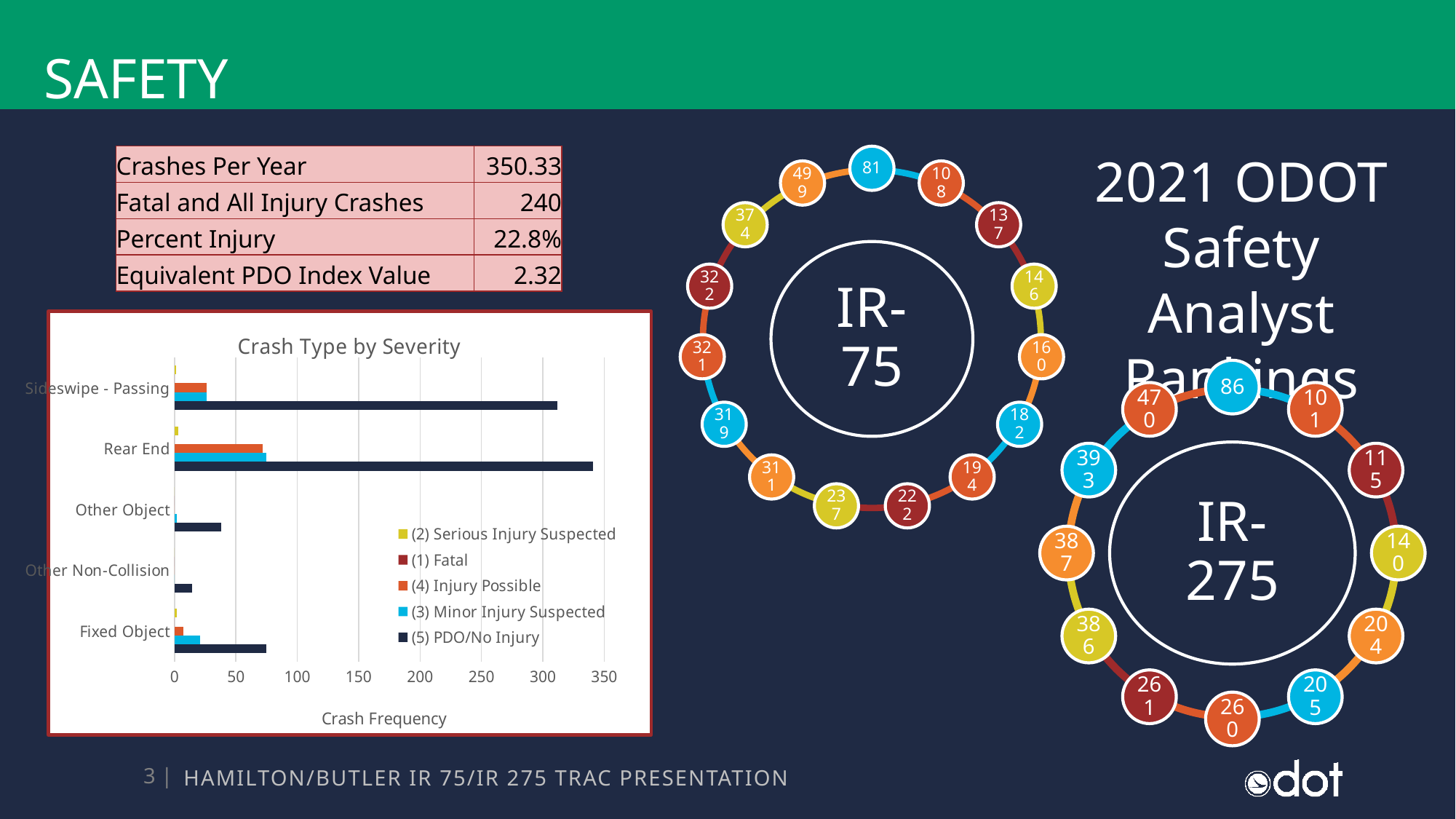
In the "Crash Type by Severity" chart, which crash type has the larger (5) PDO/No Injury value: Fixed Object or Other Object? Fixed Object What is the x-axis label of the "Crash Type by Severity" chart? Crash Frequency In the "Crash Type by Severity" chart, is the (5) PDO/No Injury value for Other Object greater or less than 50? less In the "Crash Type by Severity" chart, which crash type has the lowest (5) PDO/No Injury value? Other Non-Collision How many series does the legend of the "Crash Type by Severity" chart list? 5 In the "Crash Type by Severity" chart, is the (5) PDO/No Injury value for Fixed Object greater or less than 100? less In the "Crash Type by Severity" chart, is the (5) PDO/No Injury value for Rear End greater or less than 300? greater In the "Crash Type by Severity" chart, which is larger for Rear End: the (4) Injury Possible value or the (5) PDO/No Injury value? (5) PDO/No Injury In the "Crash Type by Severity" chart, which crash type has the highest (5) PDO/No Injury value? Rear End How many crash type categories are shown in the "Crash Type by Severity" chart? 5 What kind of chart is the "Crash Type by Severity" chart? bar chart